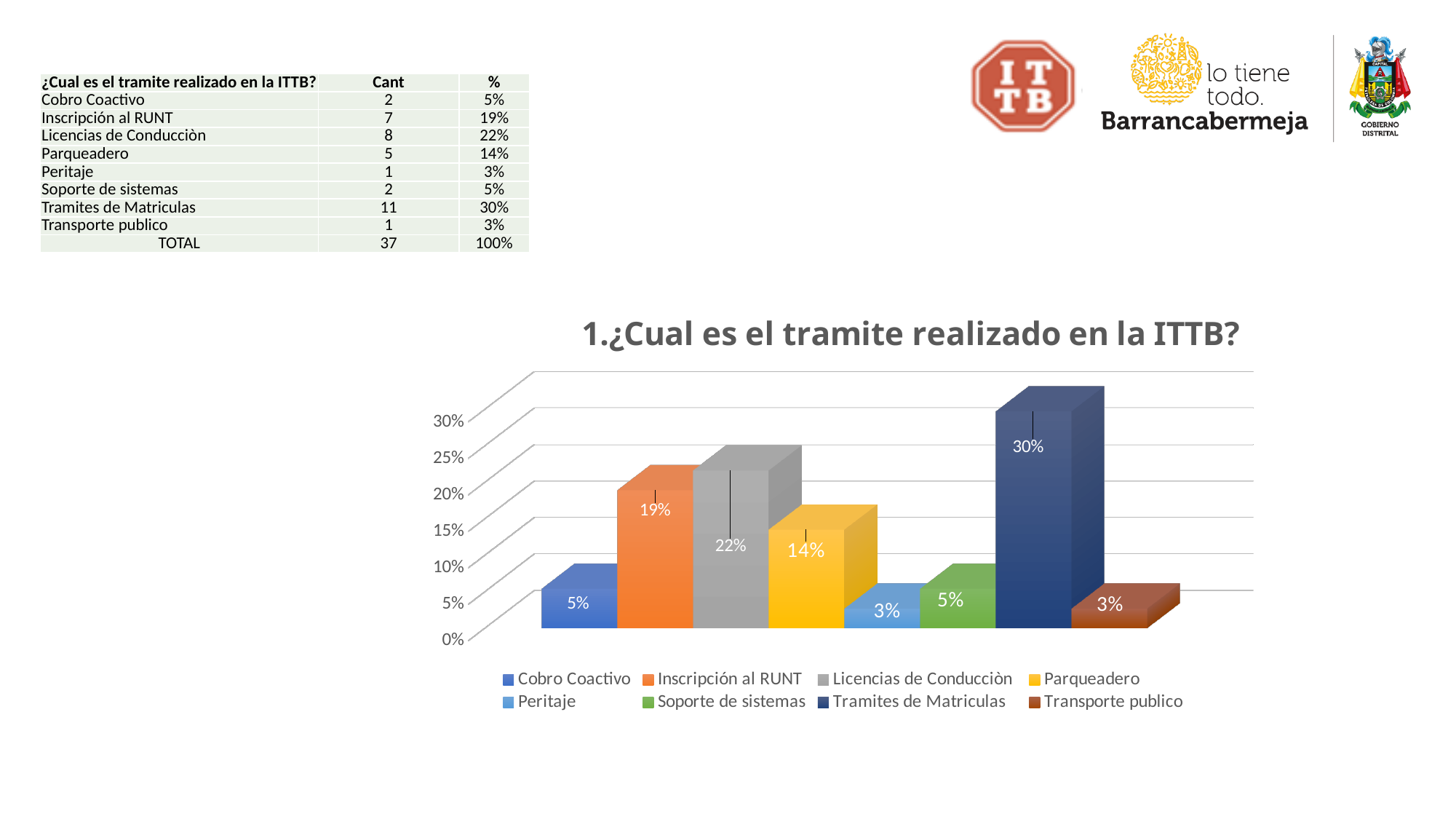
What is the value for Tramites de Matriculas? 30% How many categories are shown in the chart? 8 Which is larger, Inscripción al RUNT or Licencias de Conducciòn? Licencias de Conducciòn What is the difference between Licencias de Conducciòn and Cobro Coactivo? 17% What colour is the bar for Soporte de sistemas? green Which category has the highest value? Tramites de Matriculas How many entries does the legend list? 8 What kind of chart is shown? bar chart What is the title of the chart? 1.¿Cual es el tramite realizado en la ITTB? What is the value for Parqueadero? 14% Is the value for Tramites de Matriculas greater or less than 25%? greater What is the value for Inscripción al RUNT? 19%